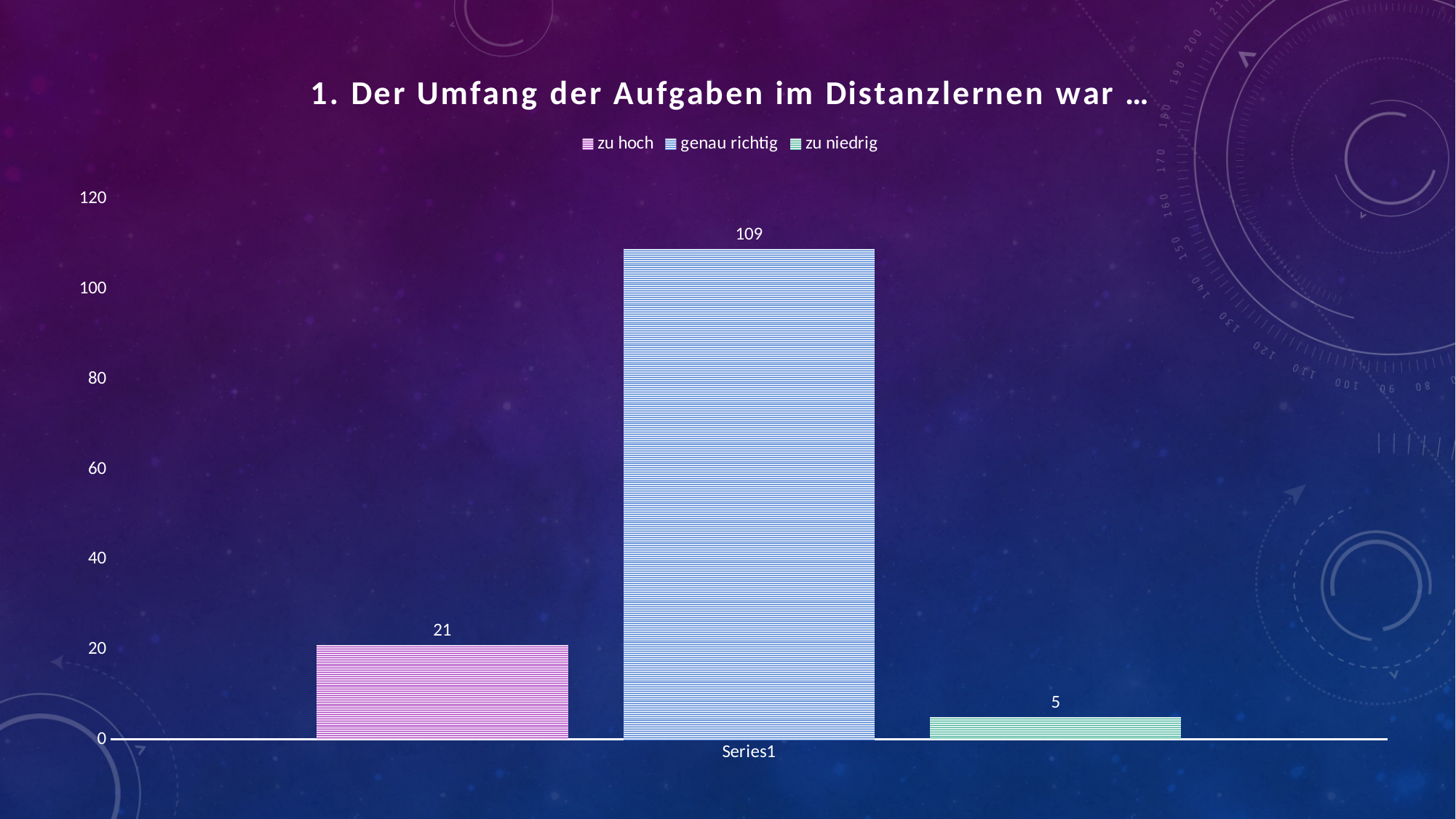
Which is larger, the value for "zu hoch" or the value for "zu niedrig"? zu hoch Which series has the highest value? genau richtig What is the value for "genau richtig"? 109 Which series has the lowest value? zu niedrig How many series does the legend list? 3 What is the value for "zu niedrig"? 5 What kind of chart is shown on the slide? bar chart What is the difference between the values for "genau richtig" and "zu hoch"? 88 What is the difference between the values for "zu hoch" and "zu niedrig"? 16 Is the value for "genau richtig" greater or less than 100? greater What is the title of the chart? 1. Der Umfang der Aufgaben im Distanzlernen war … What is the value for "zu hoch"? 21